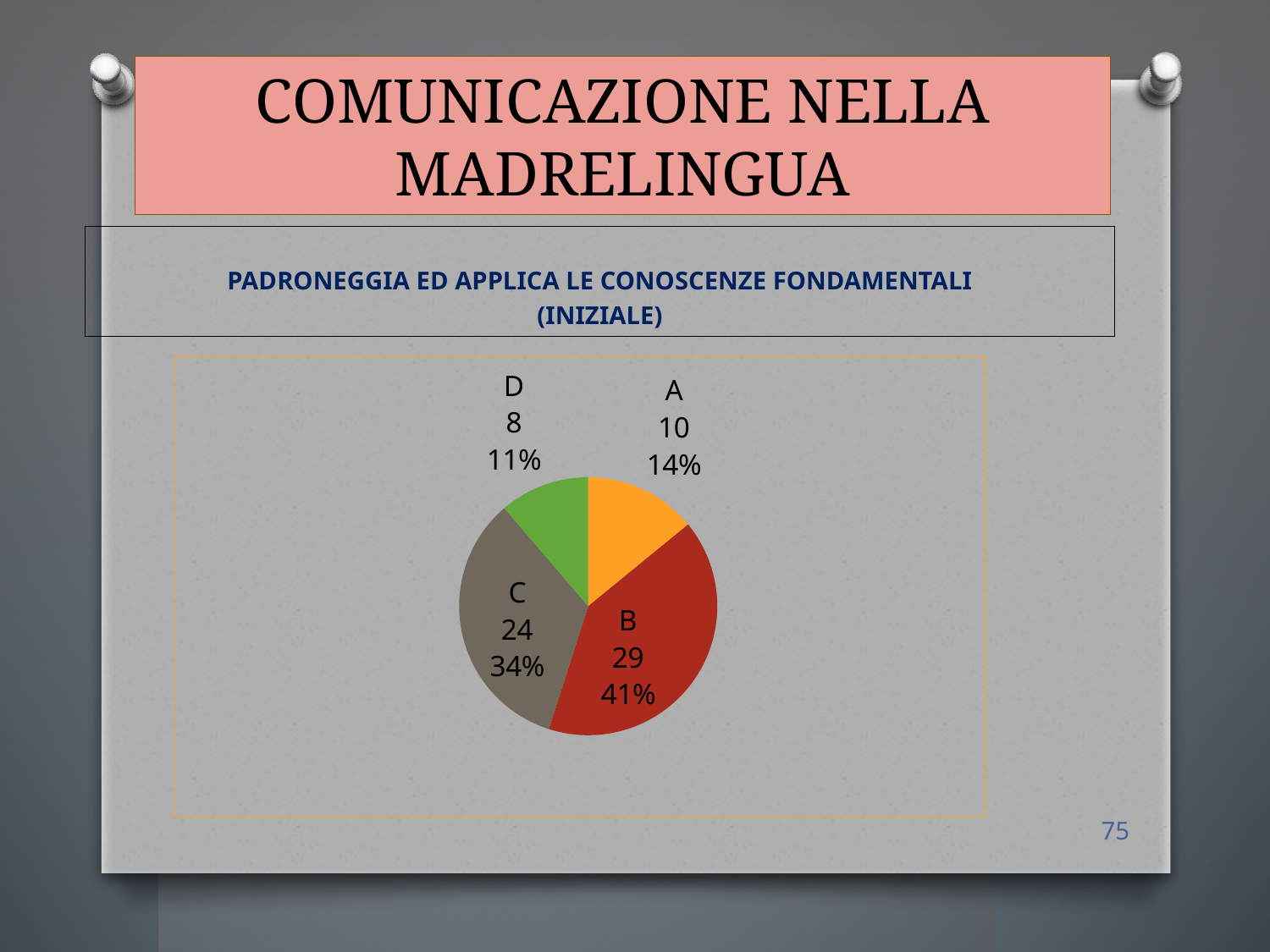
Which is larger, the value for A or the value for D? A What kind of chart is shown on the slide? pie chart What is the difference between the values for B and C? 5 What is the total of all four slice values? 71 What colour is the slice for category C? grey-brown Which category has the largest slice? B What percentage share does category A have? 14% How many slices does the pie chart have? 4 Which category has the smallest slice? D What is the value for category D? 8 What is the value for category B? 29 What percentage share does category C have? 34%